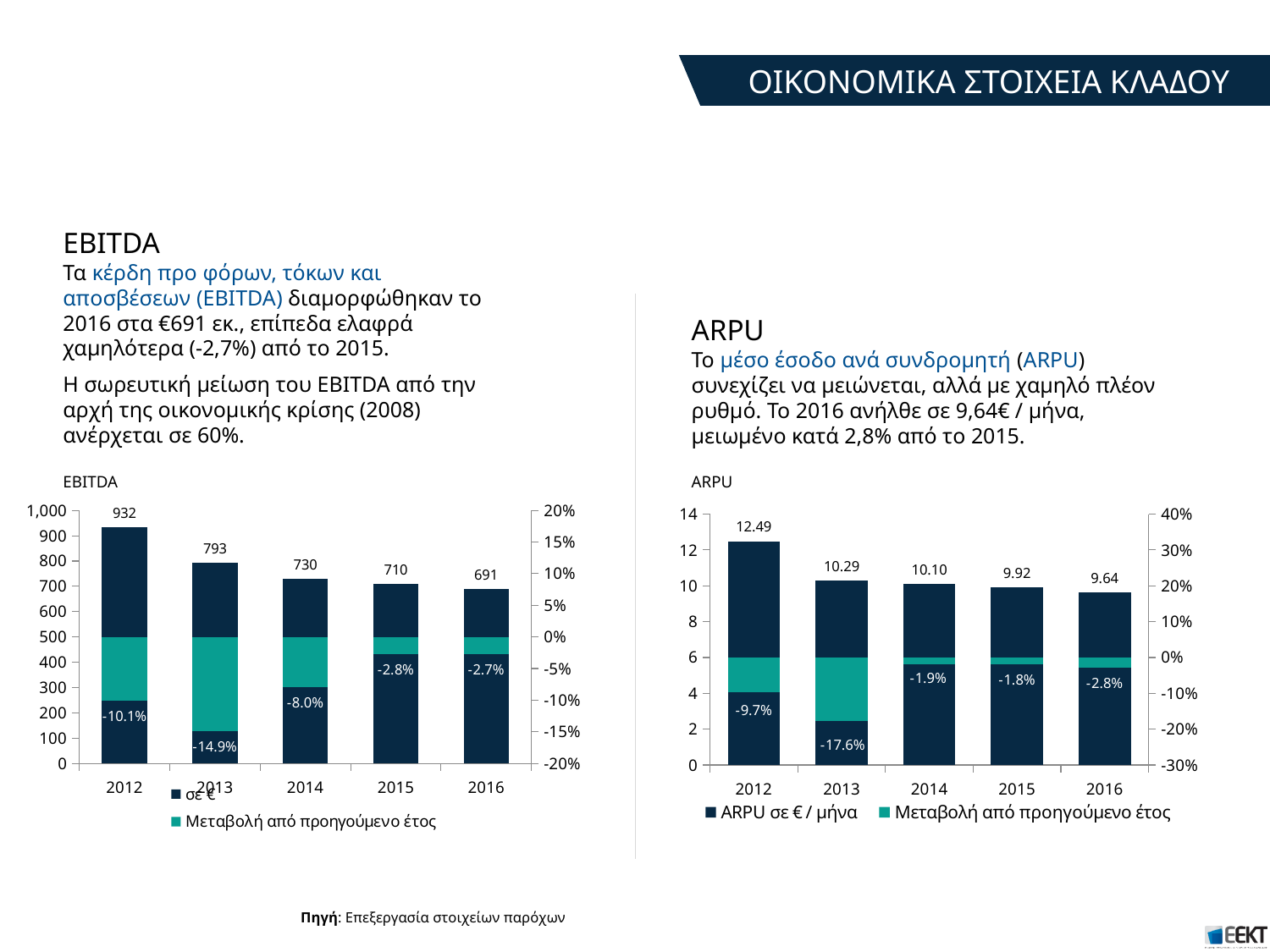
In the ARPU chart, what is the year-on-year change shown for 2016? -2.8% In the EBITDA chart, what is the difference between the EBITDA values for 2012 and 2013? 139 In the ARPU chart, which is larger, the ARPU value for 2014 or for 2015? 2014 In the ARPU chart, how many series does the legend list? 2 In the EBITDA chart, do the EBITDA values rise or fall from 2012 to 2016? fall In the ARPU chart, what is the ARPU value for 2013? 10.29 In the EBITDA chart, what is the EBITDA value for 2012? 932 In the EBITDA chart, what is the EBITDA value for 2016? 691 In the ARPU chart, how many years are shown on the x axis? 5 In the ARPU chart, which year has the lowest ARPU value? 2016 In the EBITDA chart, what is the year-on-year change shown for 2013? -14.9% In the EBITDA chart, which year has the highest EBITDA value? 2012